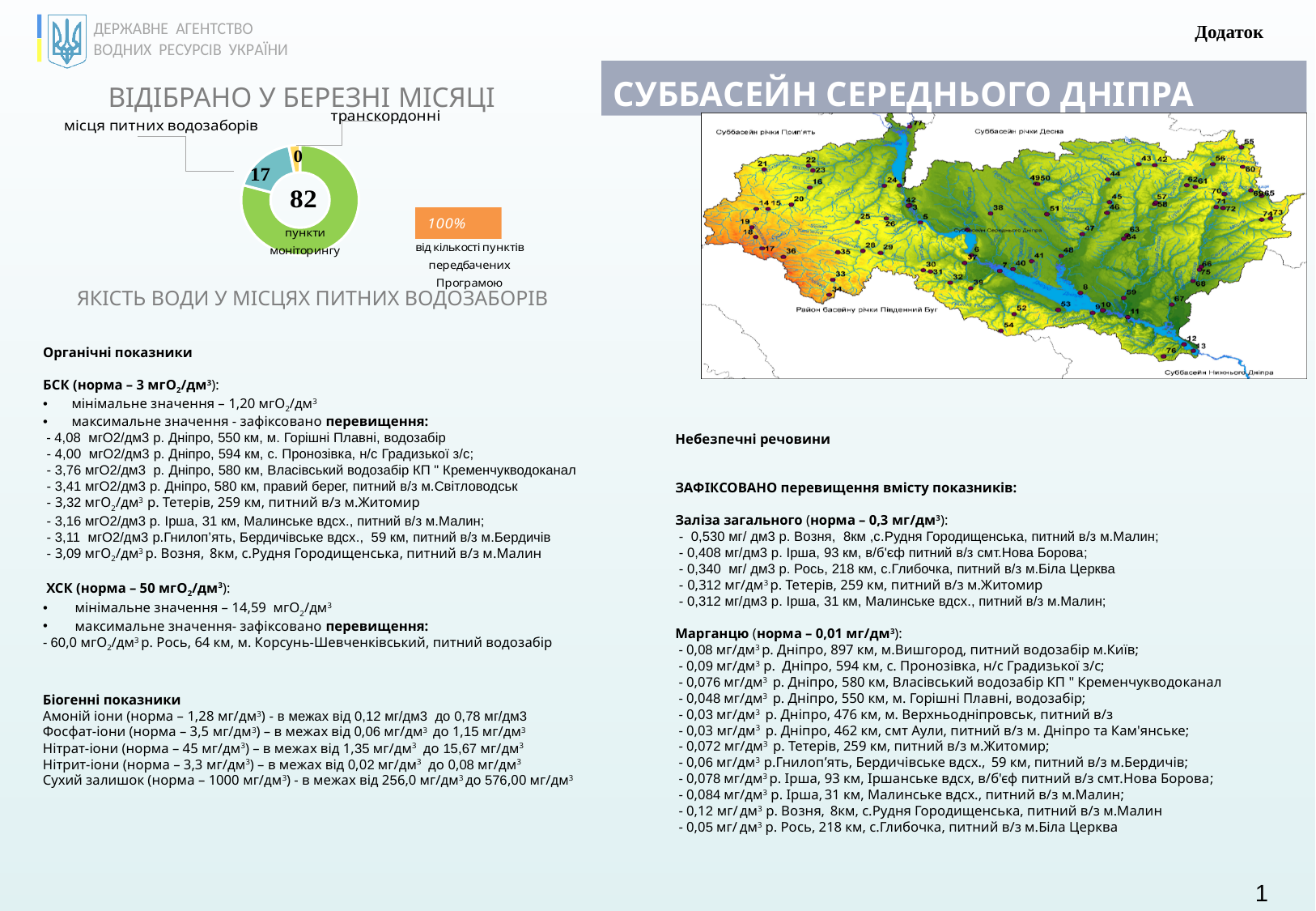
In the doughnut chart, what value is shown for 'транскордонні'? 0 What percentage is shown in the orange box next to the doughnut chart? 100% What label accompanies the number 82 in the centre of the doughnut chart? пункти моніторингу What number is printed in the centre of the doughnut chart? 82 How many labelled values are shown on the doughnut chart? 3 What colour is the segment labelled 17 in the doughnut chart? Teal (blue-green) In the doughnut chart, what value is shown for 'місця питних водозаборів'? 17 Which is larger in the doughnut chart: 'місця питних водозаборів' or 'транскордонні'? місця питних водозаборів What is the difference between the values for 'місця питних водозаборів' and 'транскордонні' in the doughnut chart? 17 Which labelled category in the doughnut chart has the lowest value? транскордонні What type of chart is shown under the heading 'ВІДІБРАНО У БЕРЕЗНІ МІСЯЦІ'? Doughnut (pie) chart